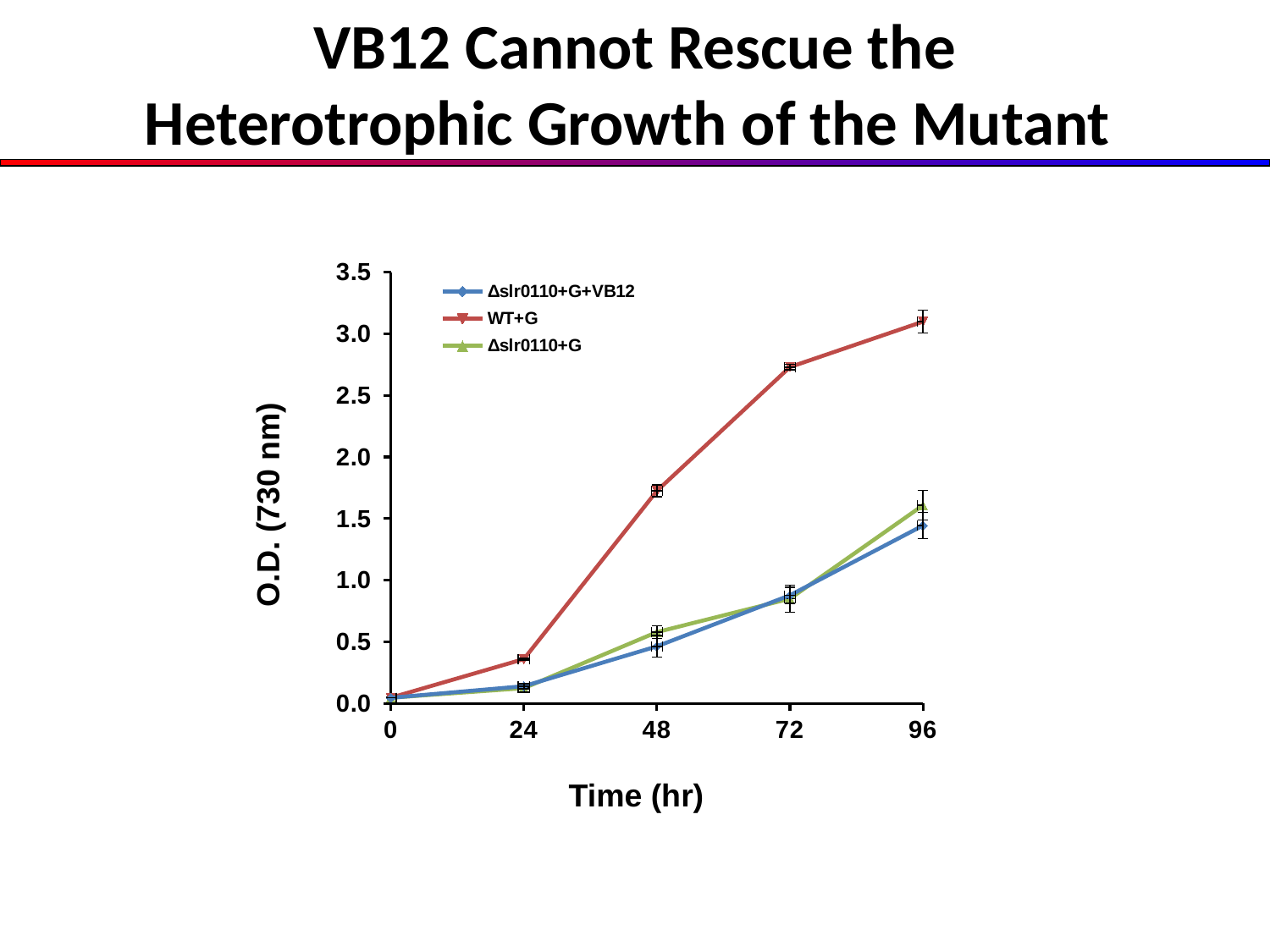
Does the O.D. for WT+G rise or fall as time increases from 0 to 96 hr? rise Which series has the highest O.D. at 96 hr? WT+G Is the value for WT+G at 24 hr greater or less than 0.5? less How many time points are plotted along the x axis? 5 What kind of chart is shown on the slide? line chart What is the label of the x axis? Time (hr) What is the label of the y axis? O.D. (730 nm) Is the value for WT+G at 72 hr greater or less than 2.5? greater At 72 hr, which is larger: the value for WT+G or the value for Δslr0110+G? WT+G How many series does the legend list? 3 Is the value for WT+G at 48 hr greater or less than 1.5? greater